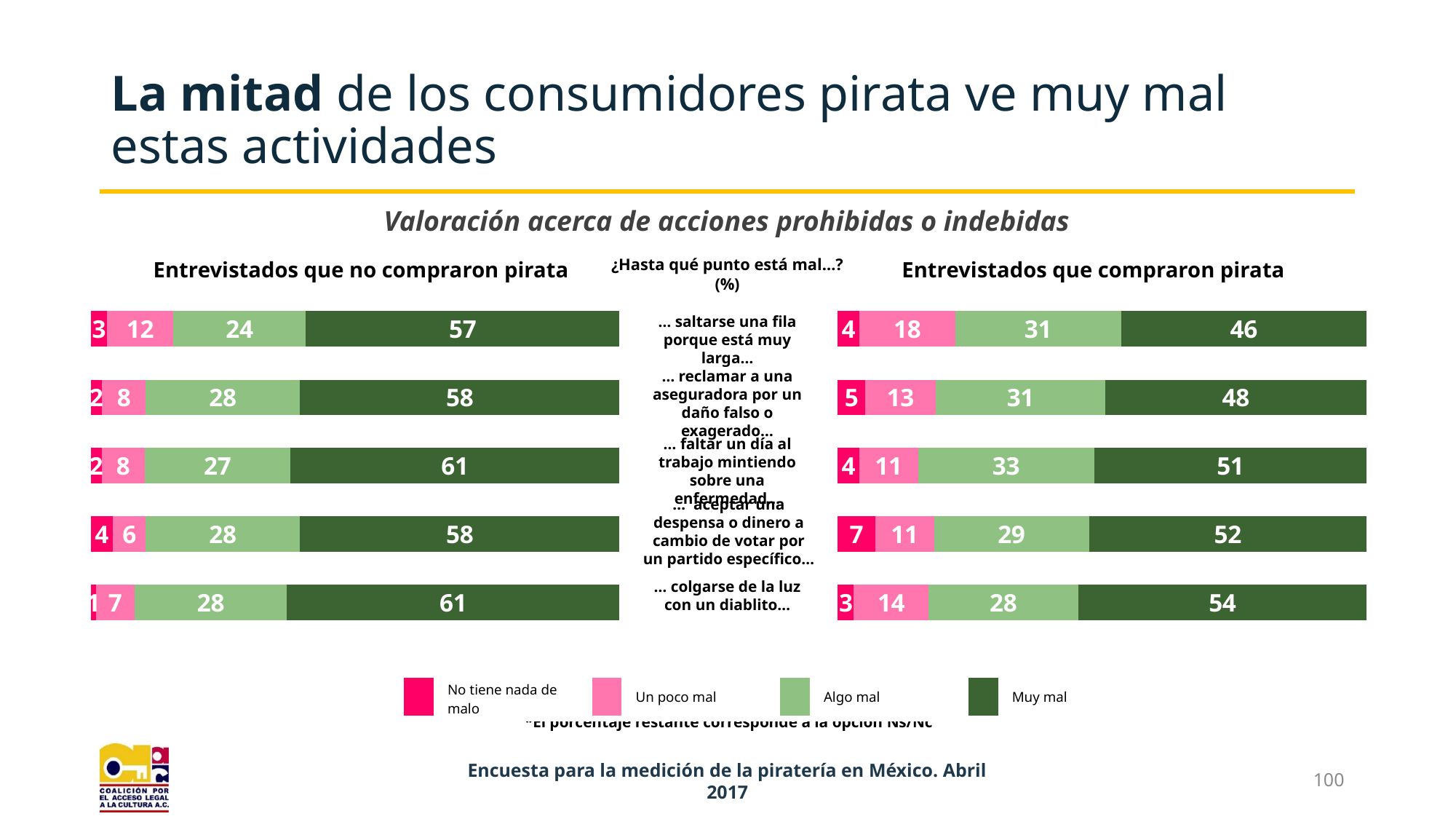
What is the difference between the 'Muy mal' value for '... saltarse una fila porque está muy larga...' in the 'Entrevistados que no compraron pirata' chart and in the 'Entrevistados que compraron pirata' chart? 11 How many activities are shown in each of the two charts? 5 Which is larger: the 'Muy mal' value for '... faltar un día al trabajo mintiendo sobre una enfermedad...' in the 'Entrevistados que no compraron pirata' chart or in the 'Entrevistados que compraron pirata' chart? Entrevistados que no compraron pirata In the chart 'Entrevistados que compraron pirata', what is the total of the stacked bar for '... aceptar una despensa o dinero a cambio de votar por un partido específico...'? 99 In the chart 'Entrevistados que compraron pirata', which activity has the lowest 'Muy mal' value? ... saltarse una fila porque está muy larga... In the chart 'Entrevistados que compraron pirata', which activity has the highest 'Muy mal' value? ... colgarse de la luz con un diablito... In the chart 'Entrevistados que compraron pirata', what is the 'Muy mal' value for '... colgarse de la luz con un diablito...'? 54 What kind of chart is used on this slide? Stacked bar chart In the chart 'Entrevistados que compraron pirata', what is the 'Un poco mal' value for '... saltarse una fila porque está muy larga...'? 18 In the chart 'Entrevistados que no compraron pirata', what is the 'Algo mal' value for '... saltarse una fila porque está muy larga...'? 24 How many series does the legend list? 4 In the chart 'Entrevistados que no compraron pirata', which activity has the lowest 'Muy mal' value? ... saltarse una fila porque está muy larga...